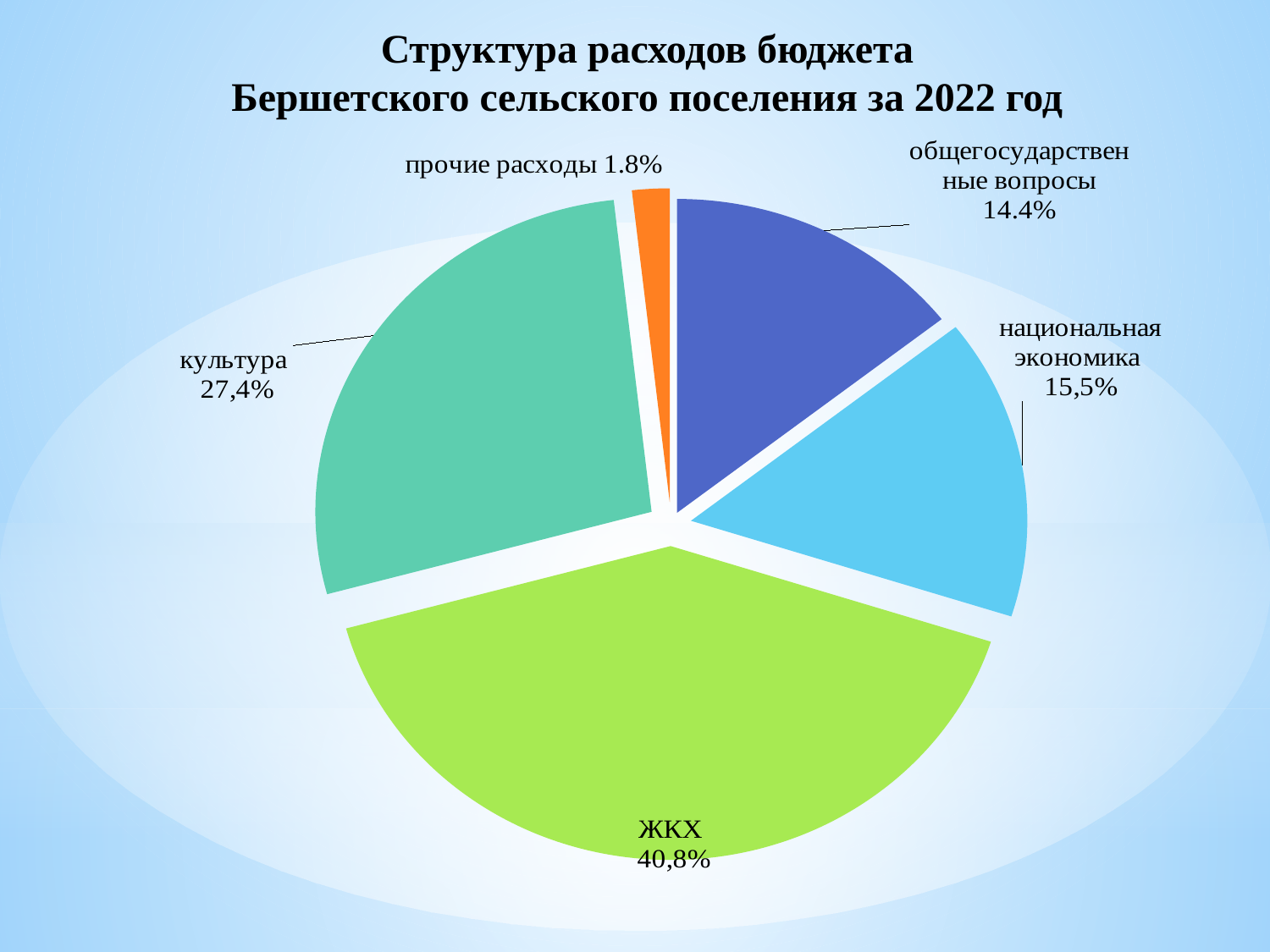
Which category has the largest share of the budget expenditure? ЖКХ By how many percentage points does the share for ЖКХ exceed the share for культура? 13,4 What share of budget expenditure is общегосударственные вопросы? 14.4% What kind of chart is shown on the slide? pie chart How many categories does the pie chart show? 5 Which is larger, the share for национальная экономика or for общегосударственные вопросы? национальная экономика What is the title of the chart? Структура расходов бюджета Бершетского сельского поселения за 2022 год What share of budget expenditure is национальная экономика? 15,5% What share of budget expenditure is культура? 27,4% What share of budget expenditure is ЖКХ? 40,8% What share of budget expenditure is прочие расходы? 1.8% Which category has the smallest share of the budget expenditure? прочие расходы